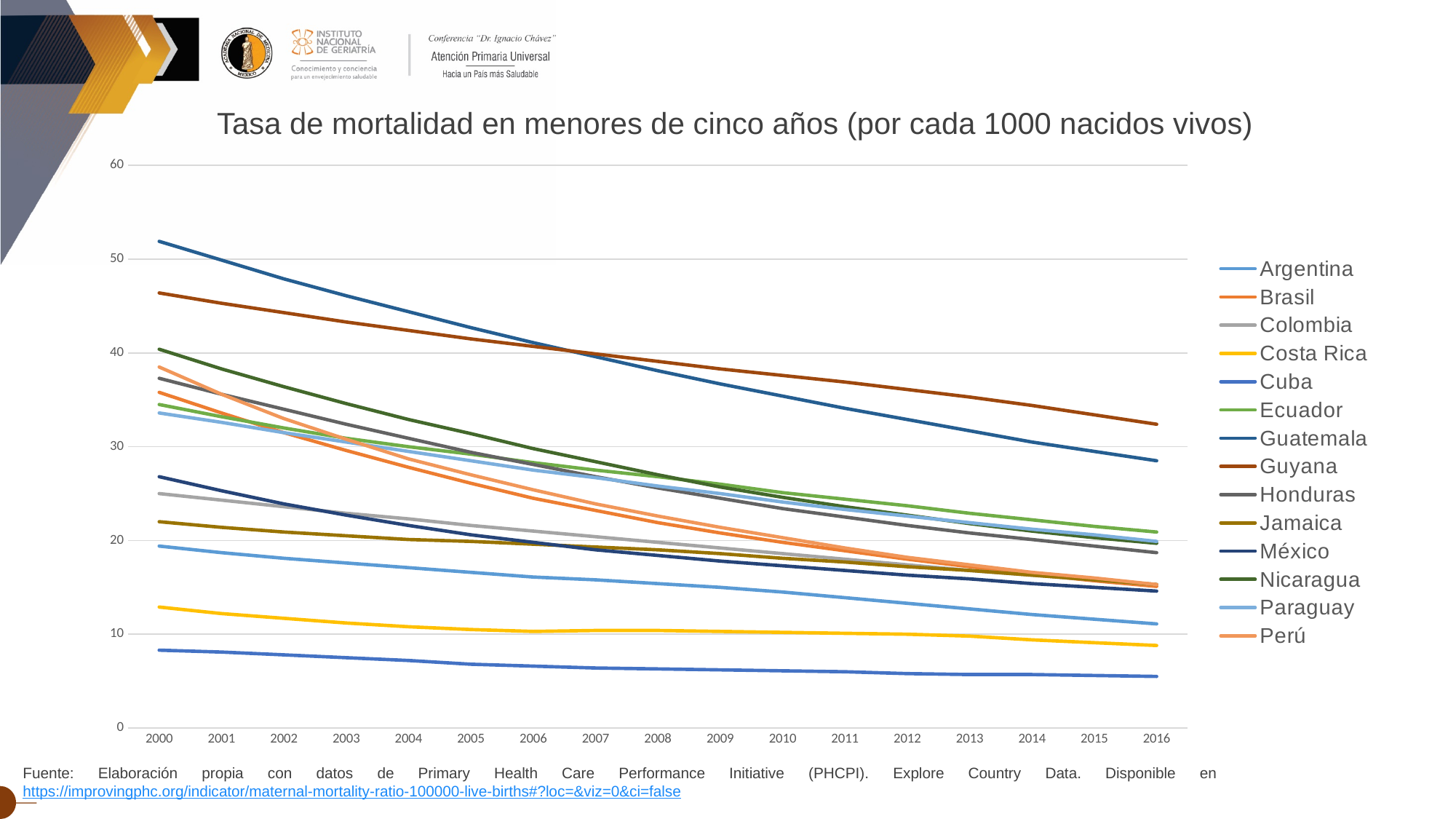
What kind of chart is shown on the slide? line chart Is the value for Cuba in 2016 greater or less than 10? less Which country has the lowest value in 2016? Cuba Is the value for Guyana in 2016 greater or less than 30? greater In 2016, which is larger, the value for Guyana or the value for Guatemala? Guyana Is the value for Guatemala in 2000 greater or less than 50? greater How many years are shown along the x axis? 17 Does the value for Guatemala rise or fall from 2000 to 2016? fall Which country has the highest value in 2000? Guatemala What is the title of the chart? Tasa de mortalidad en menores de cinco años (por cada 1000 nacidos vivos) How many series does the legend list? 14 Which country has the highest value in 2016? Guyana